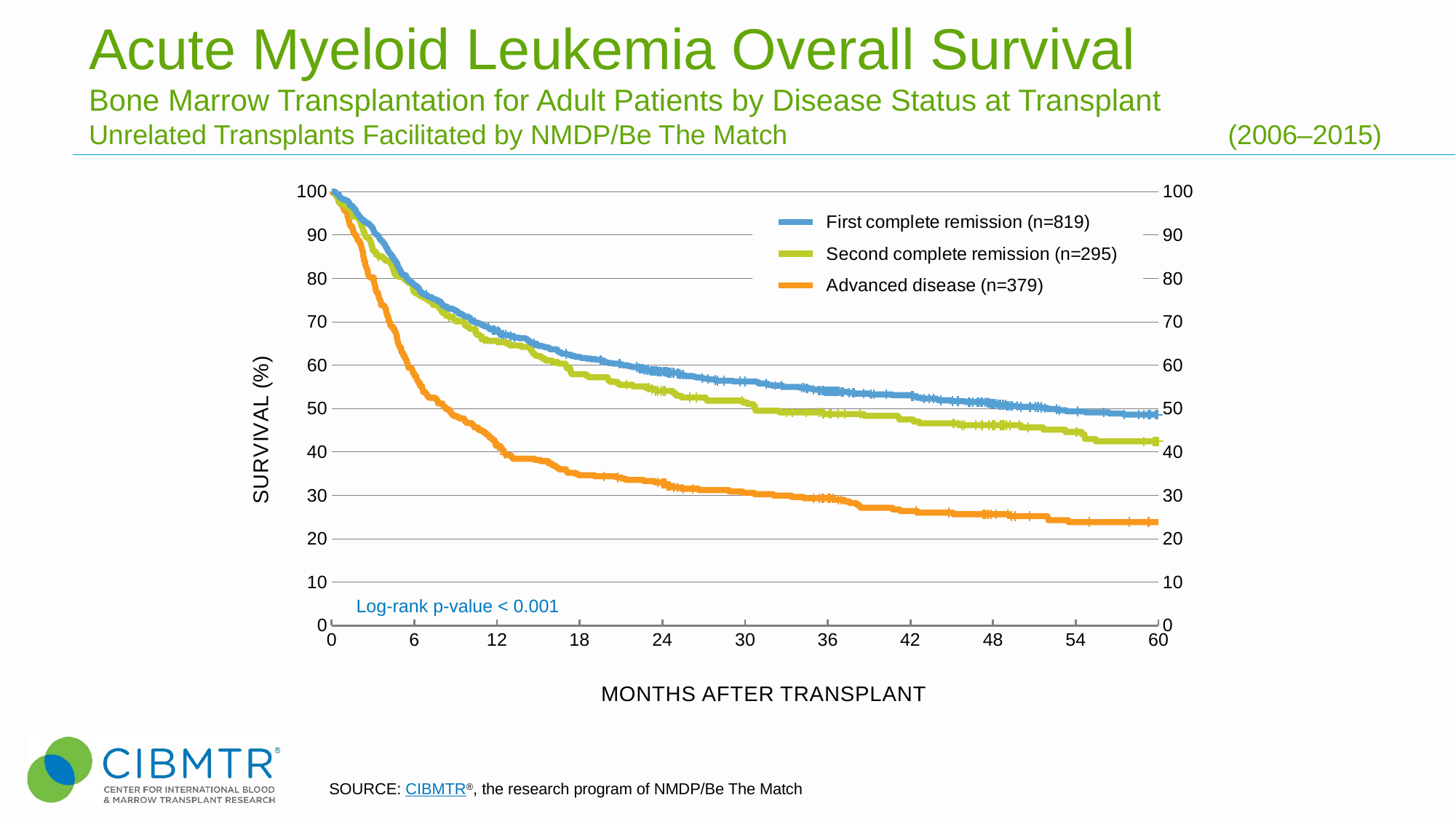
Is the survival value for First complete remission at 12 months greater or less than 60? greater How many series does the legend list? 3 Which group has the lowest survival at 60 months after transplant? Advanced disease Is the survival value for Second complete remission at 60 months greater or less than 50? less Is the survival value for Advanced disease at 60 months greater or less than 30? less Do the survival curves rise or fall as months after transplant increase? fall Which group has the highest survival at 60 months after transplant? First complete remission What is the label of the x axis? MONTHS AFTER TRANSPLANT According to the legend, how many patients are in the Advanced disease group? n=379 At 24 months after transplant, which is larger: survival for First complete remission or for Advanced disease? First complete remission What kind of chart is shown on the slide? line chart